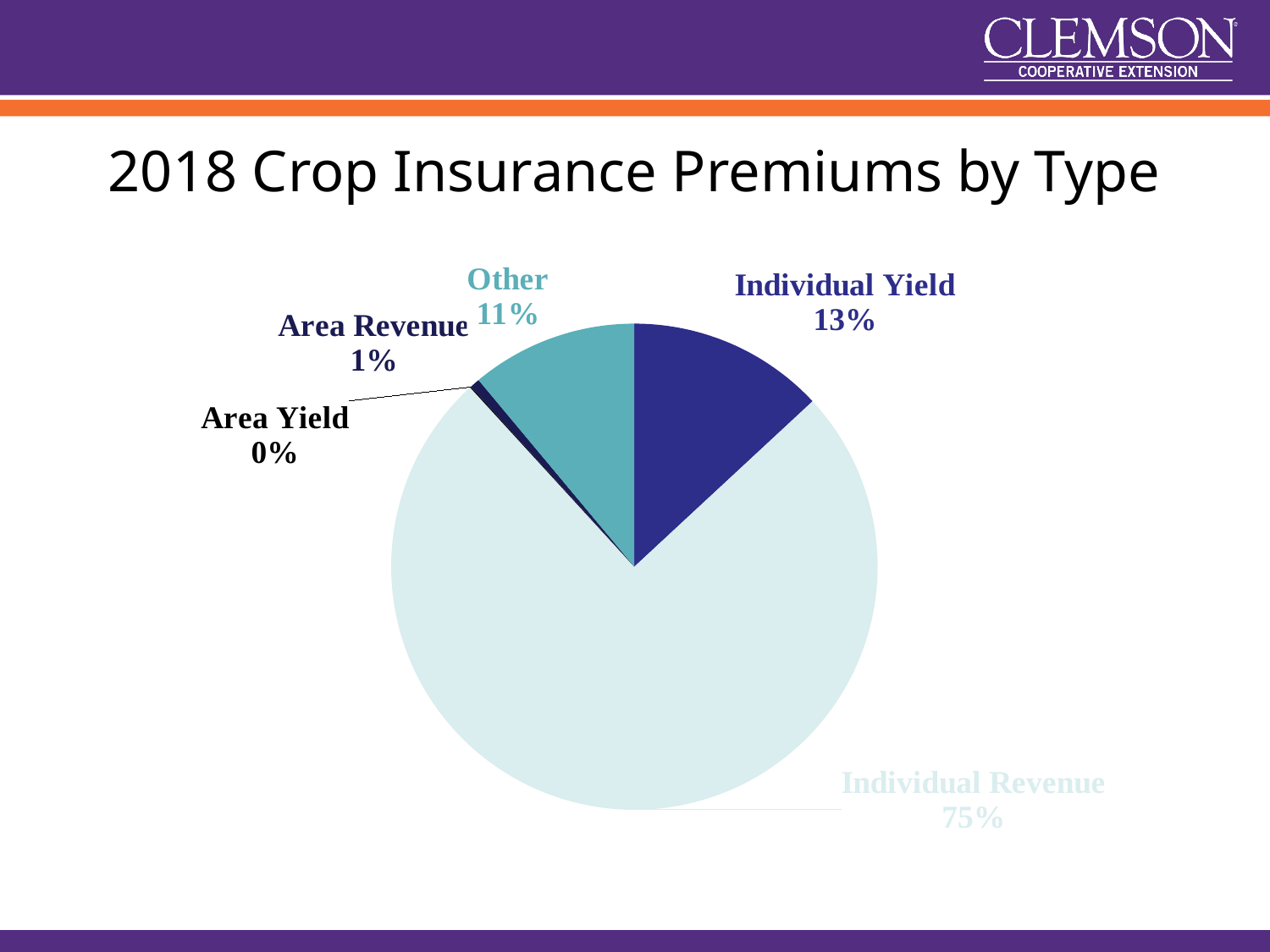
What share of 2018 crop insurance premiums is Individual Revenue? 75% What share of 2018 crop insurance premiums is Individual Yield? 13% What kind of chart is shown on the slide? pie chart What is the difference in share between Individual Revenue and Individual Yield? 62% How many slices does the pie chart have? 5 What share of 2018 crop insurance premiums is Area Revenue? 1% Which type has the smallest share of 2018 crop insurance premiums? Area Yield What is the title of the chart? 2018 Crop Insurance Premiums by Type Which has a larger share, Individual Yield or Other? Individual Yield Which type has the largest share of 2018 crop insurance premiums? Individual Revenue